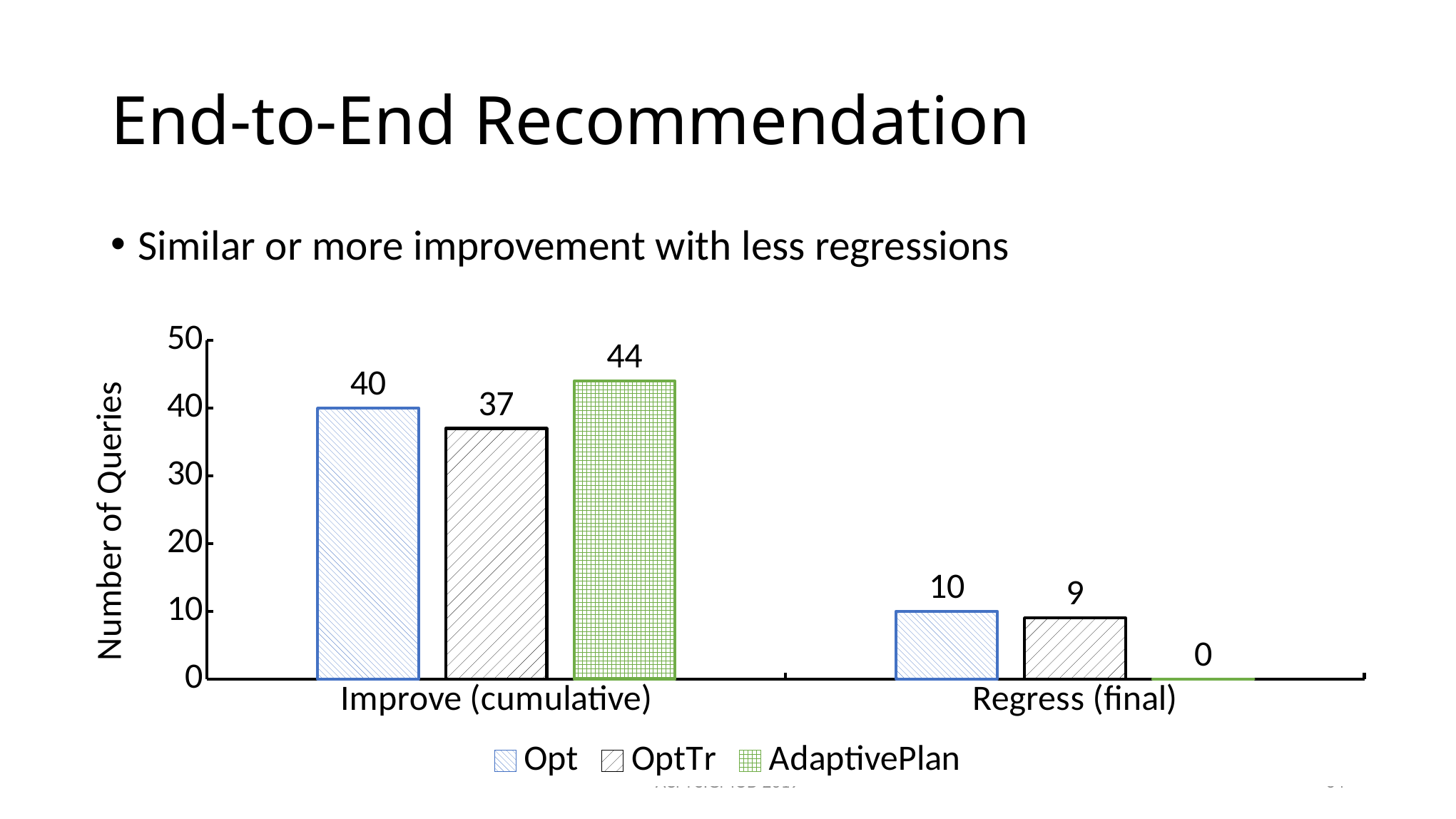
How many series does the legend list? 3 Which series has the highest value in the Improve (cumulative) category? AdaptivePlan What is the difference between the Opt and OptTr values in the Regress (final) category? 1 What kind of chart is shown on the slide? bar chart What is the value for OptTr in the Regress (final) category? 9 How many categories are shown on the x axis? 2 Which is larger in the Improve (cumulative) category, Opt or OptTr? Opt What is the value for Opt in the Improve (cumulative) category? 40 What is the value for AdaptivePlan in the Improve (cumulative) category? 44 What is the difference between the AdaptivePlan and OptTr values in the Improve (cumulative) category? 7 Which series has the lowest value in the Regress (final) category? AdaptivePlan What is the label of the y axis? Number of Queries